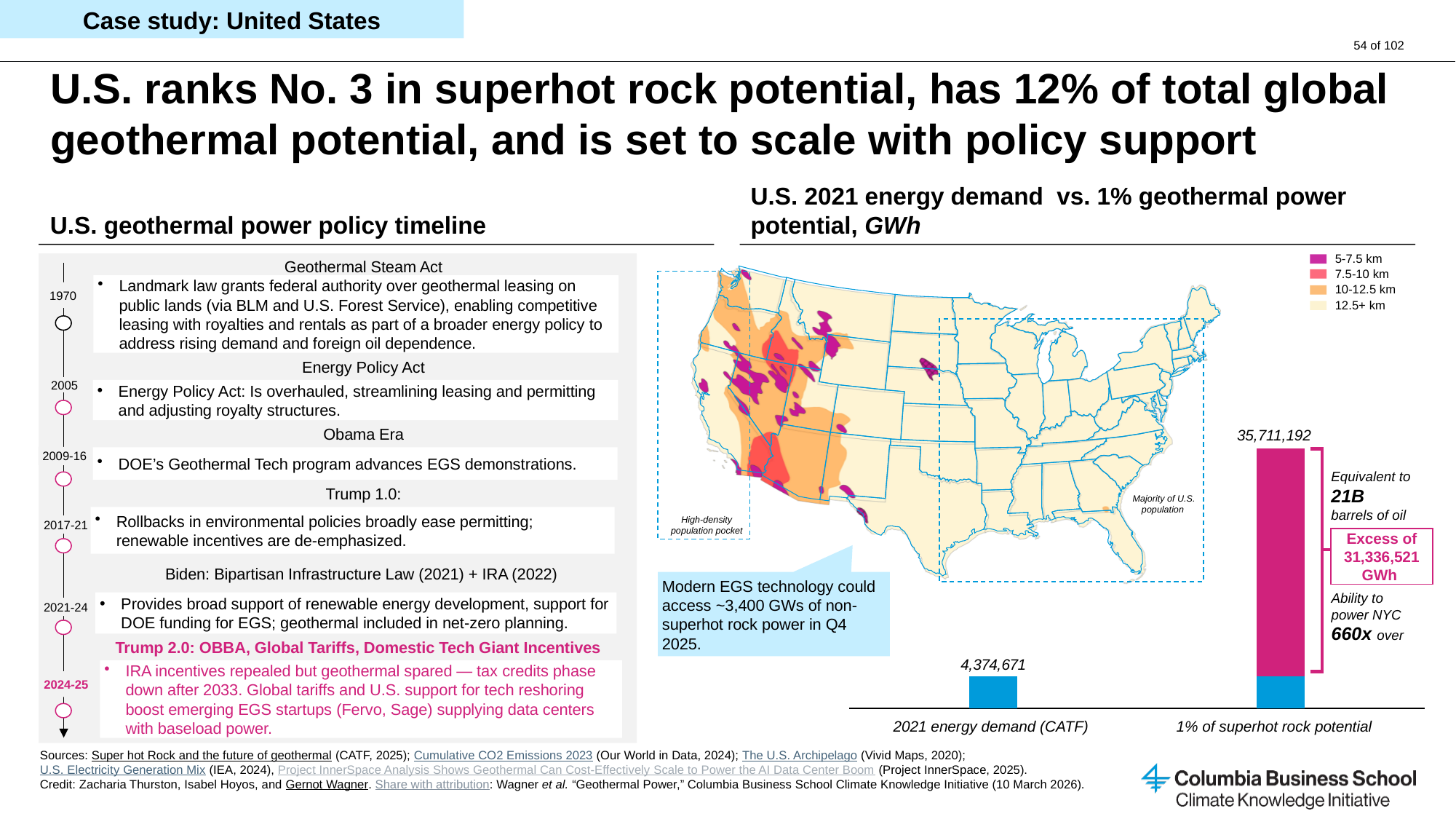
What is the value for 1% of superhot rock potential in the bar chart? 35,711,192 What kind of chart compares 2021 energy demand with 1% of superhot rock potential? bar chart According to the annotation on the bar chart, how many barrels of oil is the 1% of superhot rock potential equivalent to? 21B Which category in the bar chart has the lower value? 2021 energy demand (CATF) What unit is stated in the title of the bar chart? GWh How many categories are shown on the x axis of the bar chart? 2 What is the difference between 1% of superhot rock potential and 2021 energy demand (CATF) in the bar chart? 31,336,521 GWh Which depth range in the map legend is shown in the darkest magenta colour? 5-7.5 km Which category in the bar chart has the higher value? 1% of superhot rock potential Is the value for 2021 energy demand (CATF) larger or smaller than the value for 1% of superhot rock potential? smaller How many depth ranges does the map legend list? 4 What is the value for 2021 energy demand (CATF) in the bar chart? 4,374,671